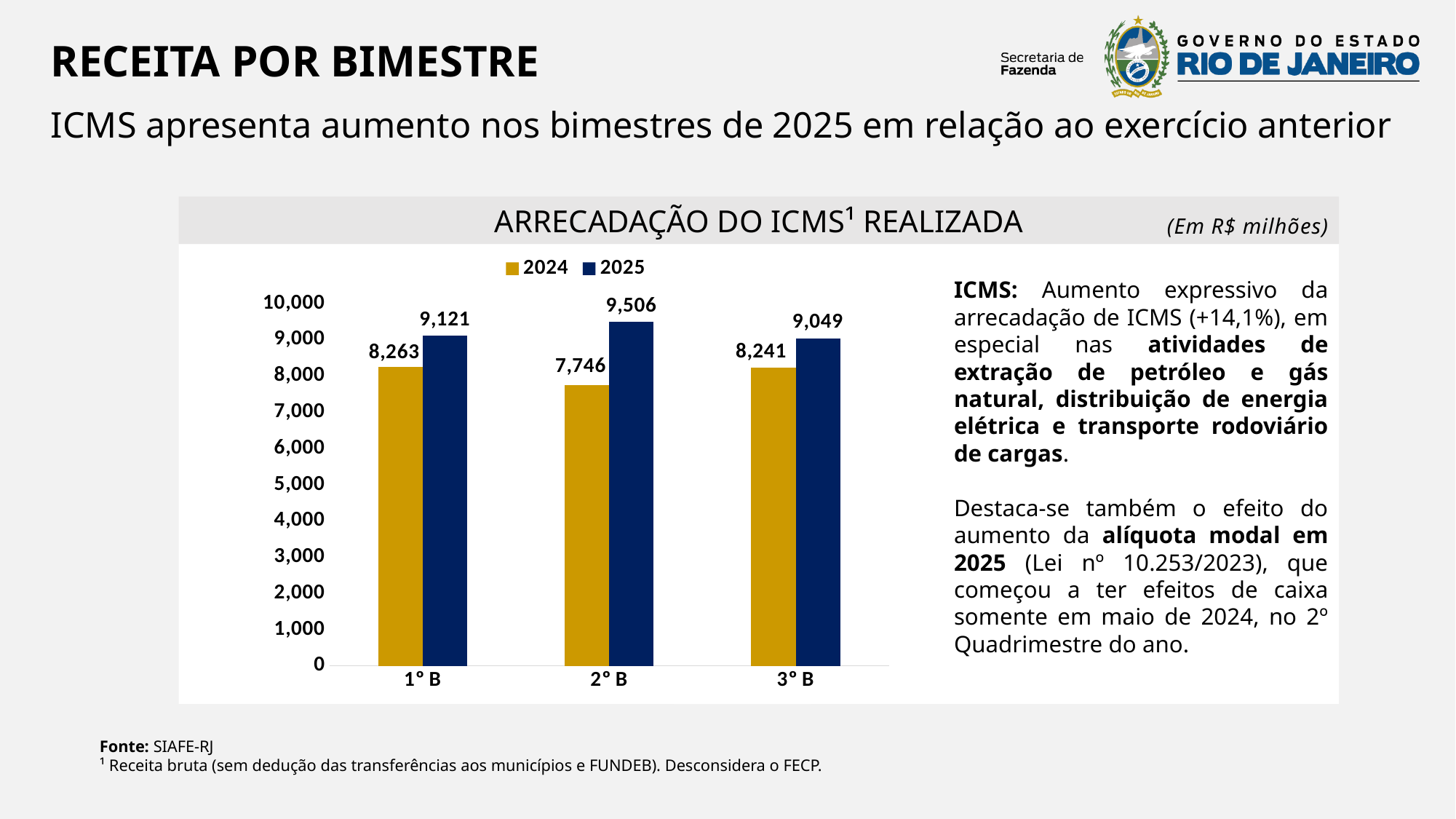
What is the difference between the 2025 and 2024 values for 2° B? 1,760 Which is larger for 3° B, the 2024 value or the 2025 value? 2025 Is the 2024 value for 2° B greater or less than 8,000? less What is the 2024 value for 1° B? 8,263 What kind of chart is shown on the slide? bar chart How many bimesters are shown on the x axis? 3 What is the difference between the 2025 values for 1° B and 3° B? 72 Which bimester has the lowest 2024 value? 2° B How many series does the legend list? 2 What is the 2025 value for 2° B? 9,506 What is the 2024 value for 3° B? 8,241 Which bimester has the highest 2025 value? 2° B